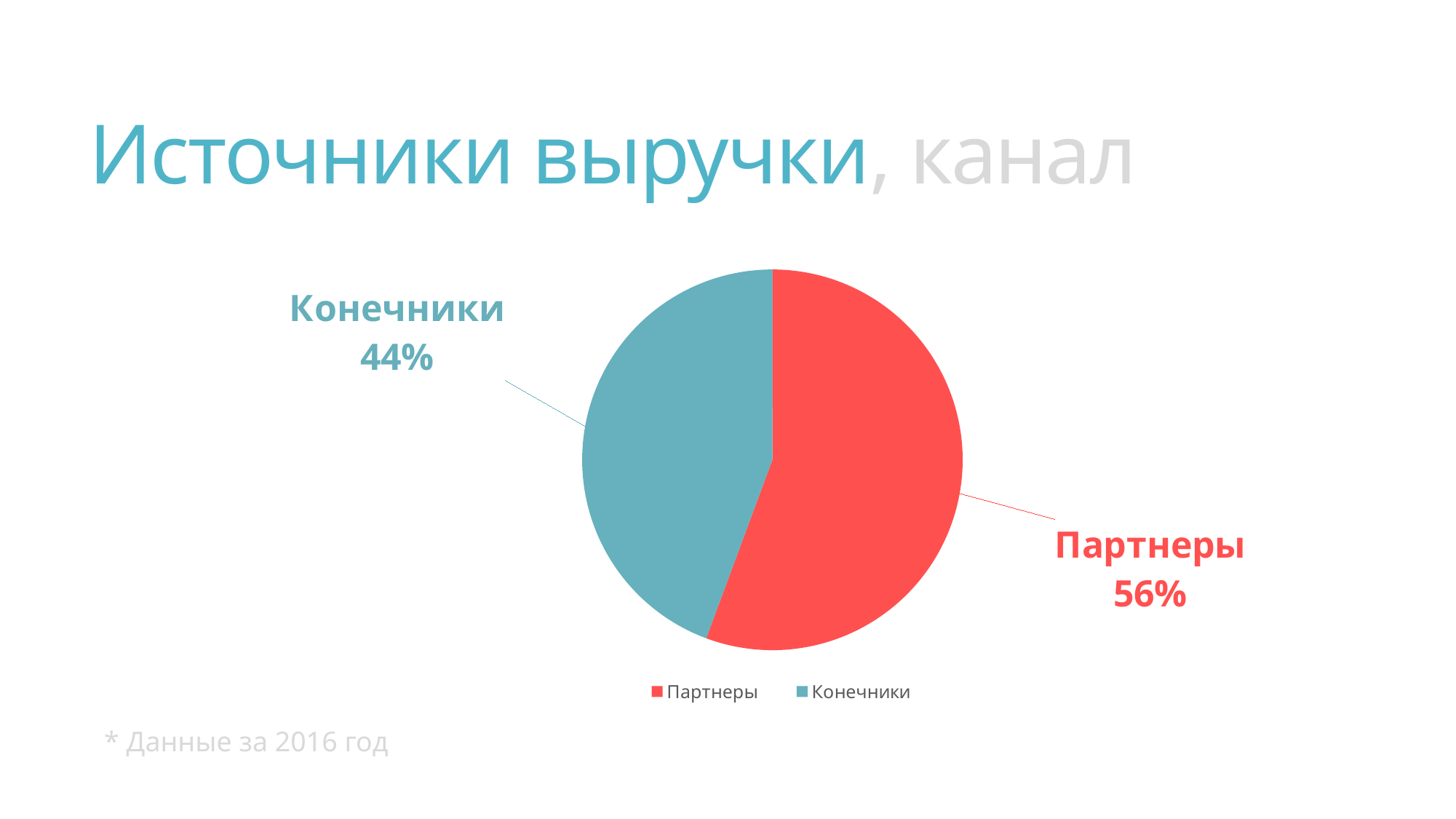
What year do the data on the slide refer to, according to the footnote? 2016 What is the difference in percentage points between Партнеры and Конечники? 12 Which is larger, the share for Партнеры or the share for Конечники? Партнеры How many entries does the legend list? 2 What share of revenue comes from Партнеры? 56% What share of revenue comes from Конечники? 44% How many slices does the pie chart have? 2 Which category has the smallest share of the pie? Конечники What kind of chart is shown on the slide? pie chart What colour is the Партнеры slice? red Which category has the largest share of the pie? Партнеры